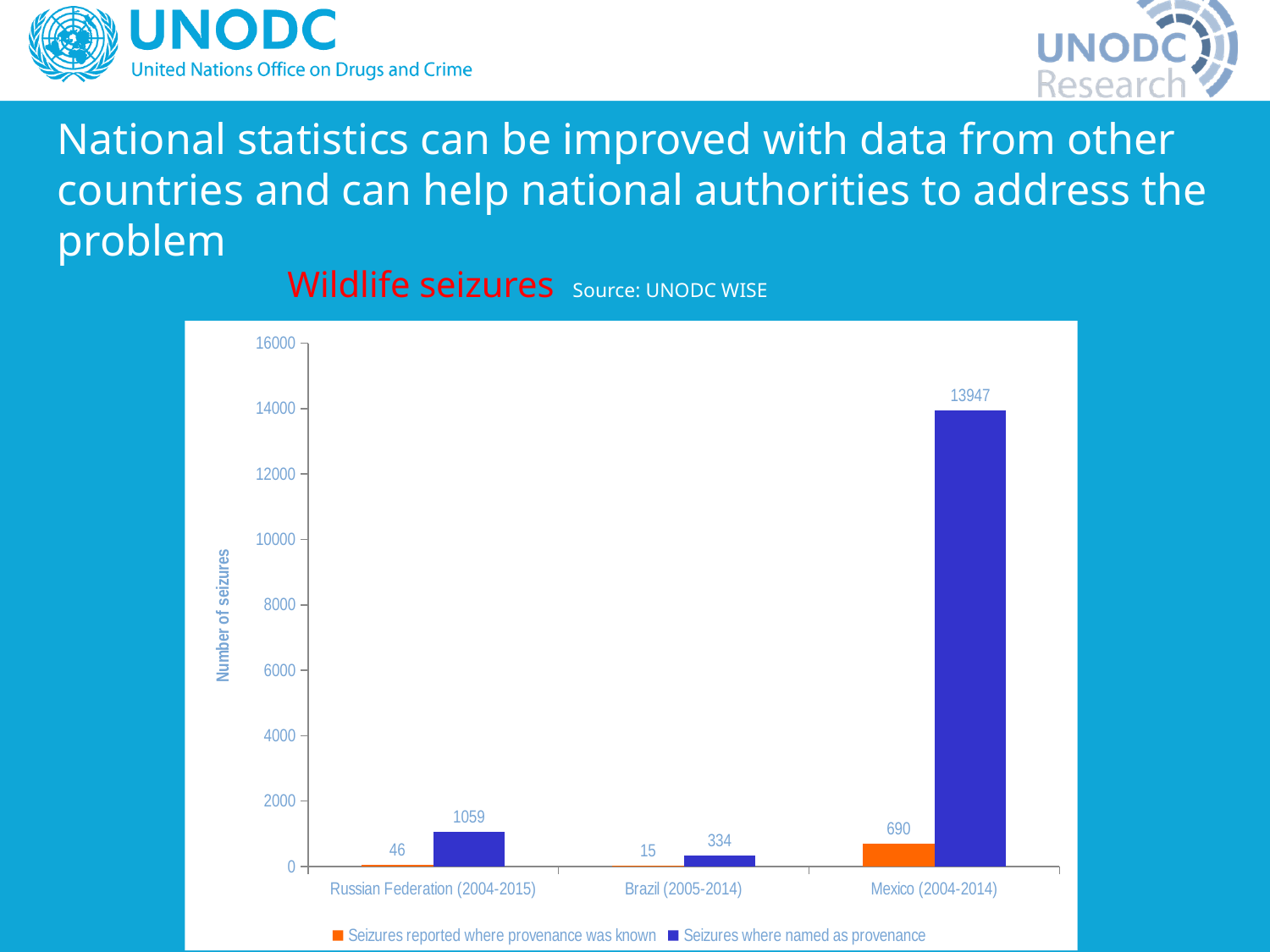
What is the value of 'Seizures reported where provenance was known' for the Russian Federation (2004-2015)? 46 Which country has the highest value for 'Seizures where named as provenance'? Mexico (2004-2014) How many countries are shown on the x axis of the chart? 3 Which is larger for Brazil (2005-2014): 'Seizures reported where provenance was known' or 'Seizures where named as provenance'? Seizures where named as provenance Is the value of 'Seizures where named as provenance' for Mexico (2004-2014) greater or less than 12000? greater What is the difference between 'Seizures where named as provenance' and 'Seizures reported where provenance was known' for the Russian Federation (2004-2015)? 1013 What is the value of 'Seizures reported where provenance was known' for Mexico (2004-2014)? 690 How many series does the legend list? 2 What is the value of 'Seizures where named as provenance' for Brazil (2005-2014)? 334 Which country has the lowest value for 'Seizures reported where provenance was known'? Brazil (2005-2014) What kind of chart is shown on the slide? bar chart What is the value of 'Seizures where named as provenance' for Mexico (2004-2014)? 13947